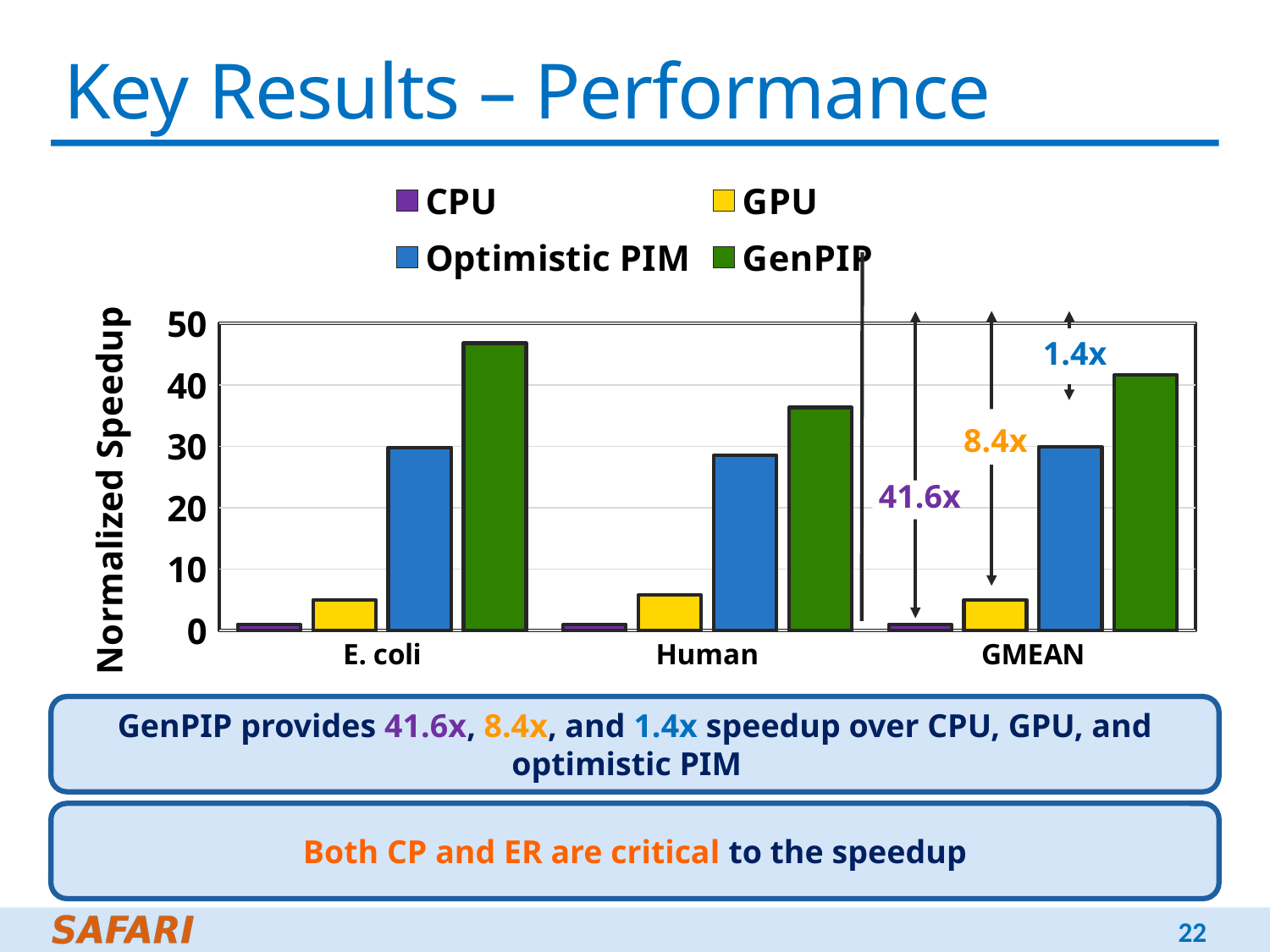
What kind of chart is shown on the slide? bar chart How many categories are shown on the x axis? 3 Is the GenPIP bar for E. coli larger or smaller than the GenPIP bar for Human? larger Is the value for GPU on Human greater or less than 10? less Which series has the lowest bar for Human? CPU How many series does the legend list? 4 Which is larger for Human: the GPU bar or the Optimistic PIM bar? Optimistic PIM Which series has the highest bar for E. coli? GenPIP Is the value for Optimistic PIM on GMEAN greater or less than 20? greater Is the value for GenPIP on E. coli greater or less than 40? greater Which series has the highest bar for GMEAN? GenPIP What speedup annotation is shown for GenPIP over GPU at GMEAN? 8.4x